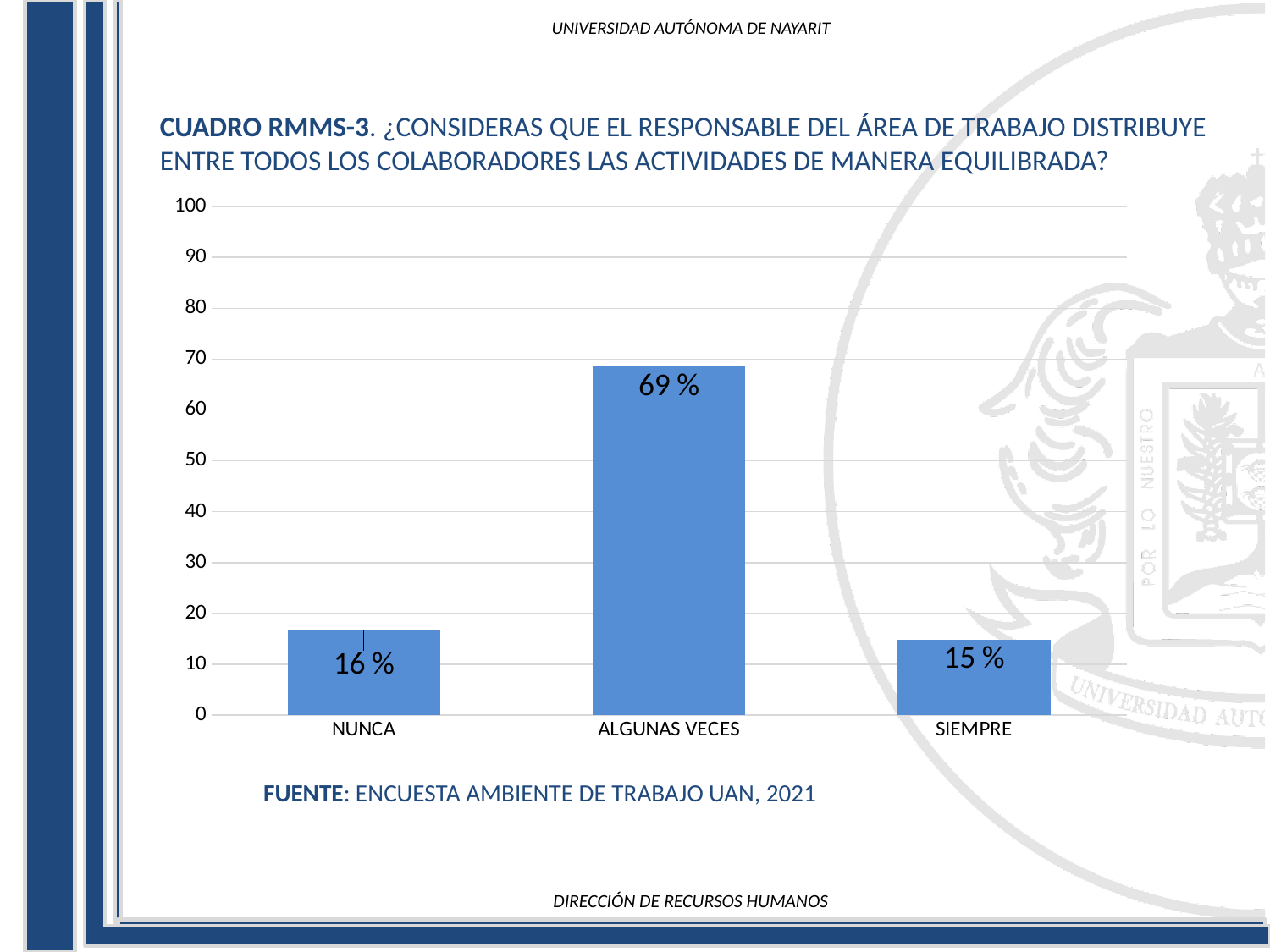
Is the value for NUNCA greater or less than 20? less How many categories are shown on the x axis? 3 Which category has the highest value? ALGUNAS VECES What is the difference between the values for NUNCA and SIEMPRE? 1 % What is the value for ALGUNAS VECES? 69 % Which category has the lowest value? SIEMPRE Which is larger, the value for ALGUNAS VECES or the value for SIEMPRE? ALGUNAS VECES What is the value for SIEMPRE? 15 % What is the value for NUNCA? 16 % Is the value for ALGUNAS VECES greater or less than 60? greater What is the difference between the values for ALGUNAS VECES and NUNCA? 53 % What kind of chart is shown on the slide? bar chart